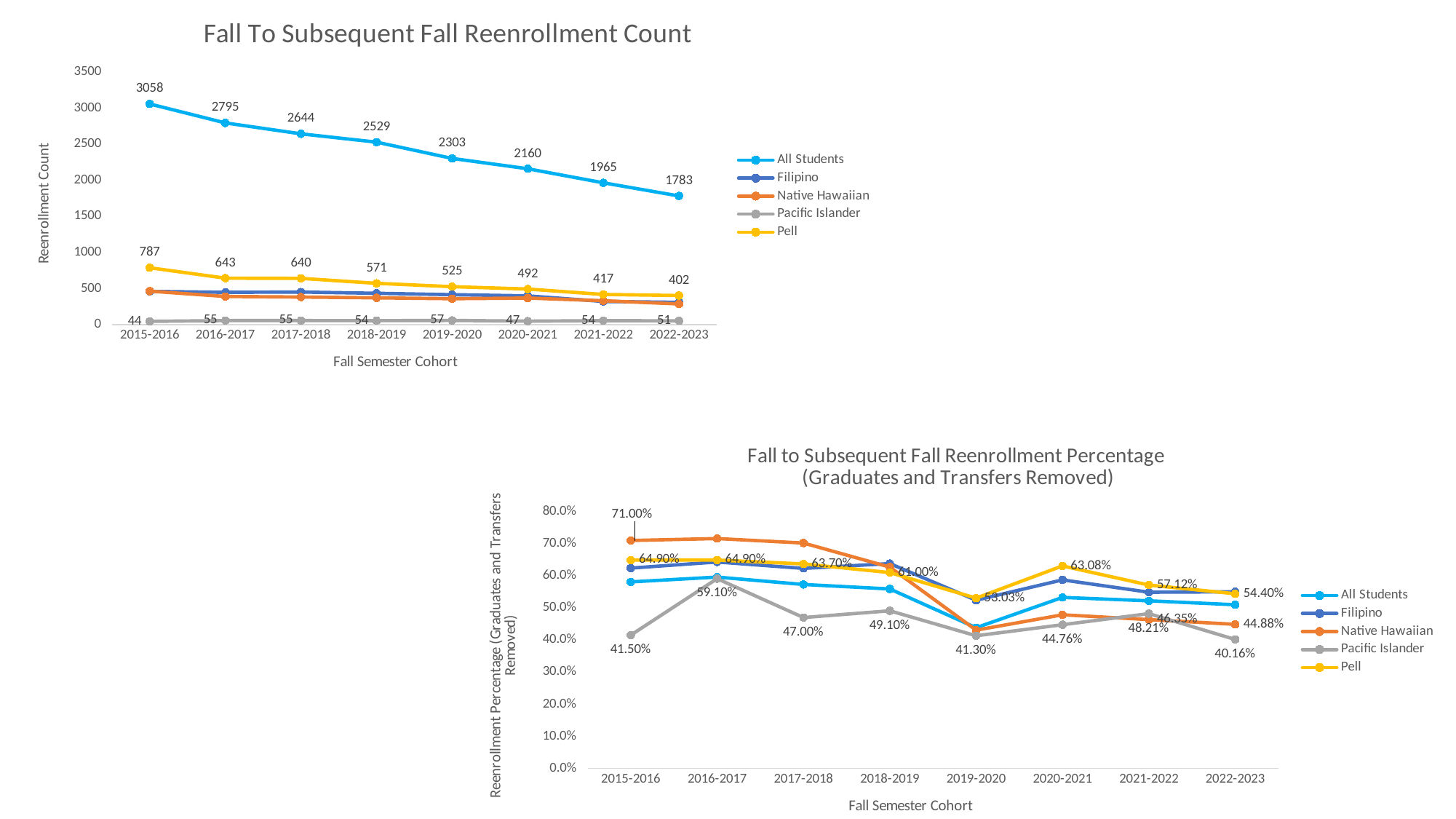
In the 'Fall To Subsequent Fall Reenrollment Count' chart, which cohort has the highest Pacific Islander count? 2019-2020 In the 'Fall To Subsequent Fall Reenrollment Count' chart, what is the All Students value for 2022-2023? 1783 In the 'Fall To Subsequent Fall Reenrollment Count' chart, what is the All Students value for 2015-2016? 3058 In the 'Fall to Subsequent Fall Reenrollment Percentage' chart, what is the Native Hawaiian value for 2015-2016? 71.00% In the 'Fall To Subsequent Fall Reenrollment Count' chart, by how much did the All Students count fall from 2015-2016 to 2022-2023? 1275 How many series does the legend of the 'Fall To Subsequent Fall Reenrollment Count' chart list? 5 In the 'Fall to Subsequent Fall Reenrollment Percentage' chart, what is the Pacific Islander value for 2016-2017? 59.10% In the 'Fall To Subsequent Fall Reenrollment Count' chart, what is the Pell value for 2015-2016? 787 In the 'Fall To Subsequent Fall Reenrollment Count' chart, what is the Pacific Islander value for 2019-2020? 57 What kind of chart is the 'Fall To Subsequent Fall Reenrollment Count' chart? line chart In the 'Fall To Subsequent Fall Reenrollment Count' chart, does the All Students line rise or fall across the cohorts? fall How many fall semester cohorts are shown on the x axis of the 'Fall To Subsequent Fall Reenrollment Count' chart? 8